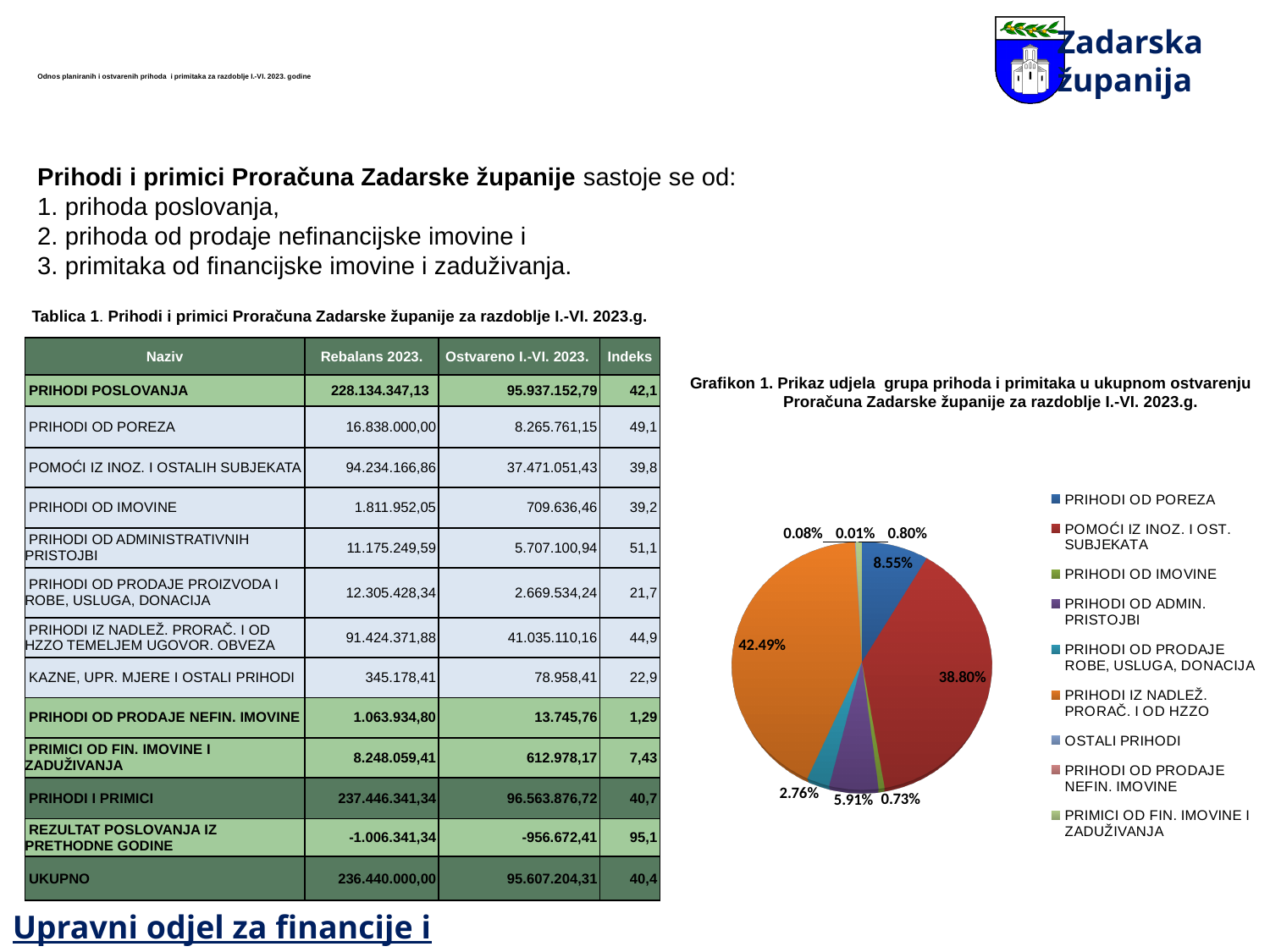
In Grafikon 1, what is the difference in percentage points between the share of PRIHODI IZ NADLEŽ. PRORAČ. I OD HZZO and POMOĆI IZ INOZ. I OST. SUBJEKATA? 3.69% In Grafikon 1, what colour is the slice for POMOĆI IZ INOZ. I OST. SUBJEKATA? red What kind of chart is Grafikon 1 on the slide? pie chart In Grafikon 1, what share does POMOĆI IZ INOZ. I OST. SUBJEKATA have? 38.80% In Grafikon 1, which category has the smallest share? PRIHODI OD PRODAJE NEFIN. IMOVINE In Grafikon 1, what is the share of PRIHODI OD PRODAJE ROBE, USLUGA, DONACIJA? 2.76% How many categories does the legend of Grafikon 1 list? 9 In Grafikon 1, which has the larger share: PRIHODI OD POREZA or PRIHODI OD ADMIN. PRISTOJBI? PRIHODI OD POREZA In Grafikon 1, which category has the largest share? PRIHODI IZ NADLEŽ. PRORAČ. I OD HZZO In Grafikon 1, what is the share of PRIHODI OD POREZA? 8.55% In Grafikon 1, what share does PRIHODI IZ NADLEŽ. PRORAČ. I OD HZZO have? 42.49% In Grafikon 1, what is the share of PRIHODI OD ADMIN. PRISTOJBI? 5.91%